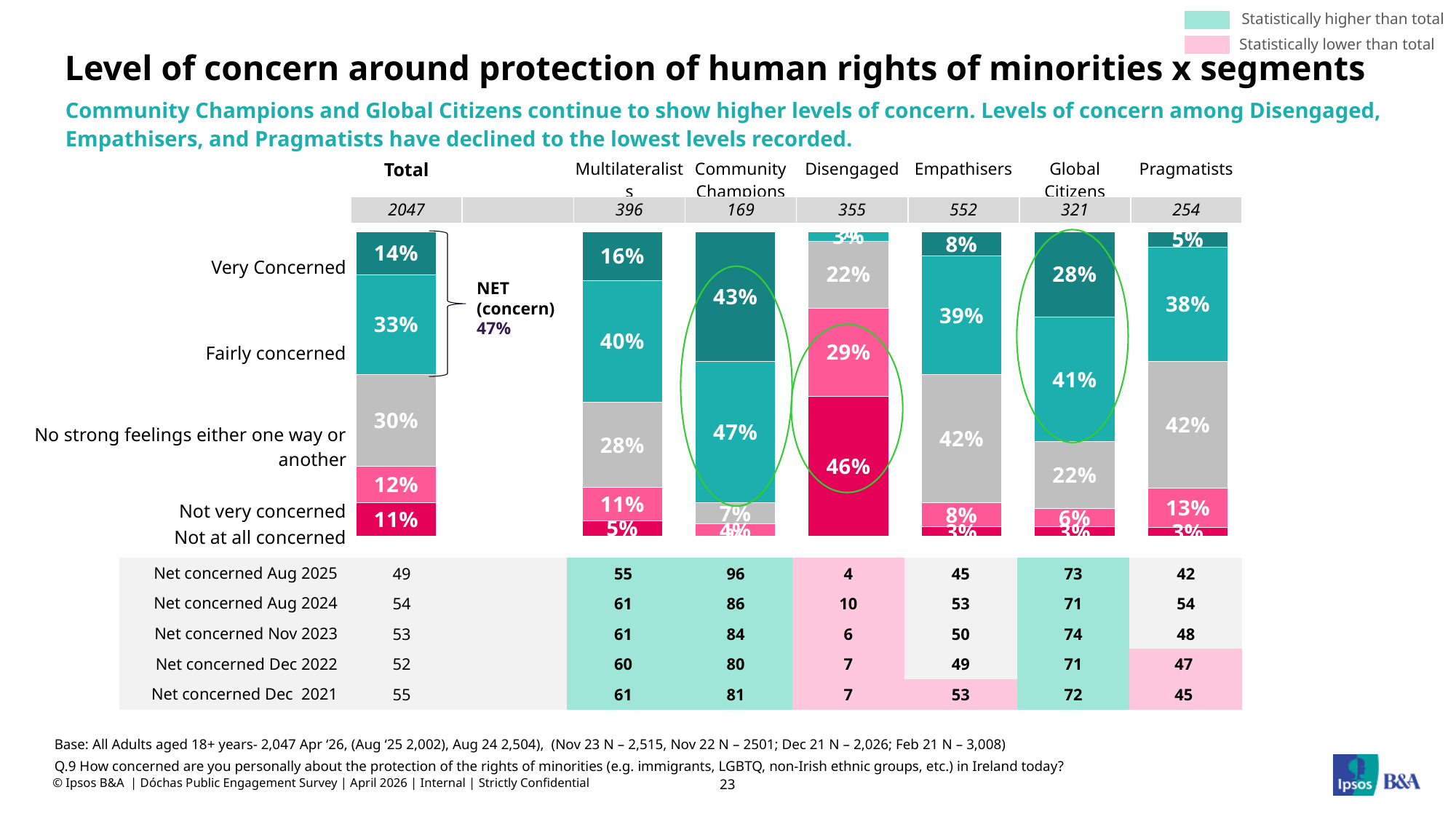
Is the share of Pragmatists with No strong feelings either one way or another larger or smaller than the share of Global Citizens with No strong feelings? larger How many segments, including Total, are shown as bars in the chart? 7 What percentage of the Disengaged segment is Not at all concerned? 46% What is the base size shown for the Empathisers segment? 552 What is the NET (concern) figure shown for the Total sample? 47% What percentage of Global Citizens are Very Concerned? 28% What is the difference between the Fairly concerned share for Multilateralists and for Empathisers? 1% Which segment has the highest share of Very Concerned respondents? Community Champions What percentage of the Total sample is Very Concerned? 14% Which segment has the lowest share of Fairly concerned respondents? Disengaged What percentage of Community Champions are Fairly concerned? 47% What kind of chart is used to show the level of concern by segment? stacked bar chart